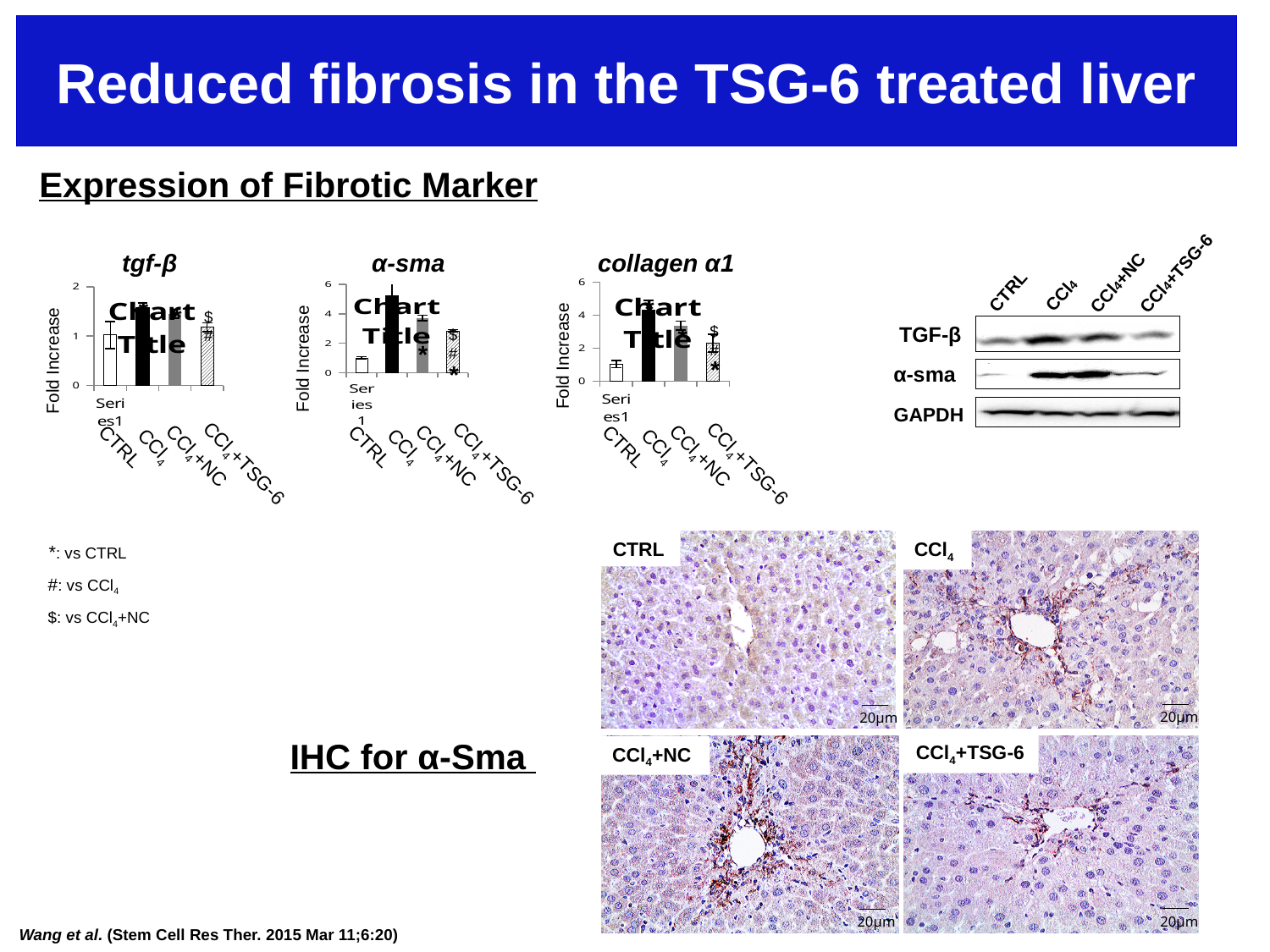
In the tgf-β chart, is the value for CCl4 greater or less than 1? greater In the α-sma chart, which category has the highest fold increase? CCl4 In the tgf-β chart, which category has the highest fold increase? CCl4 In the α-sma chart, is the value for CCl4 greater or less than 4? greater In the tgf-β chart, which category has the lowest fold increase? CTRL In the collagen α1 chart, which category has the lowest fold increase? CTRL In the α-sma chart, which is larger, the value for CCl4+NC or the value for CCl4+TSG-6? CCl4+NC In the collagen α1 chart, is the value for CCl4 greater or less than 2? greater What is the y-axis label of the collagen α1 chart? Fold Increase What kind of chart is the tgf-β chart? bar chart In the tgf-β chart, how many categories are shown on the x axis? 4